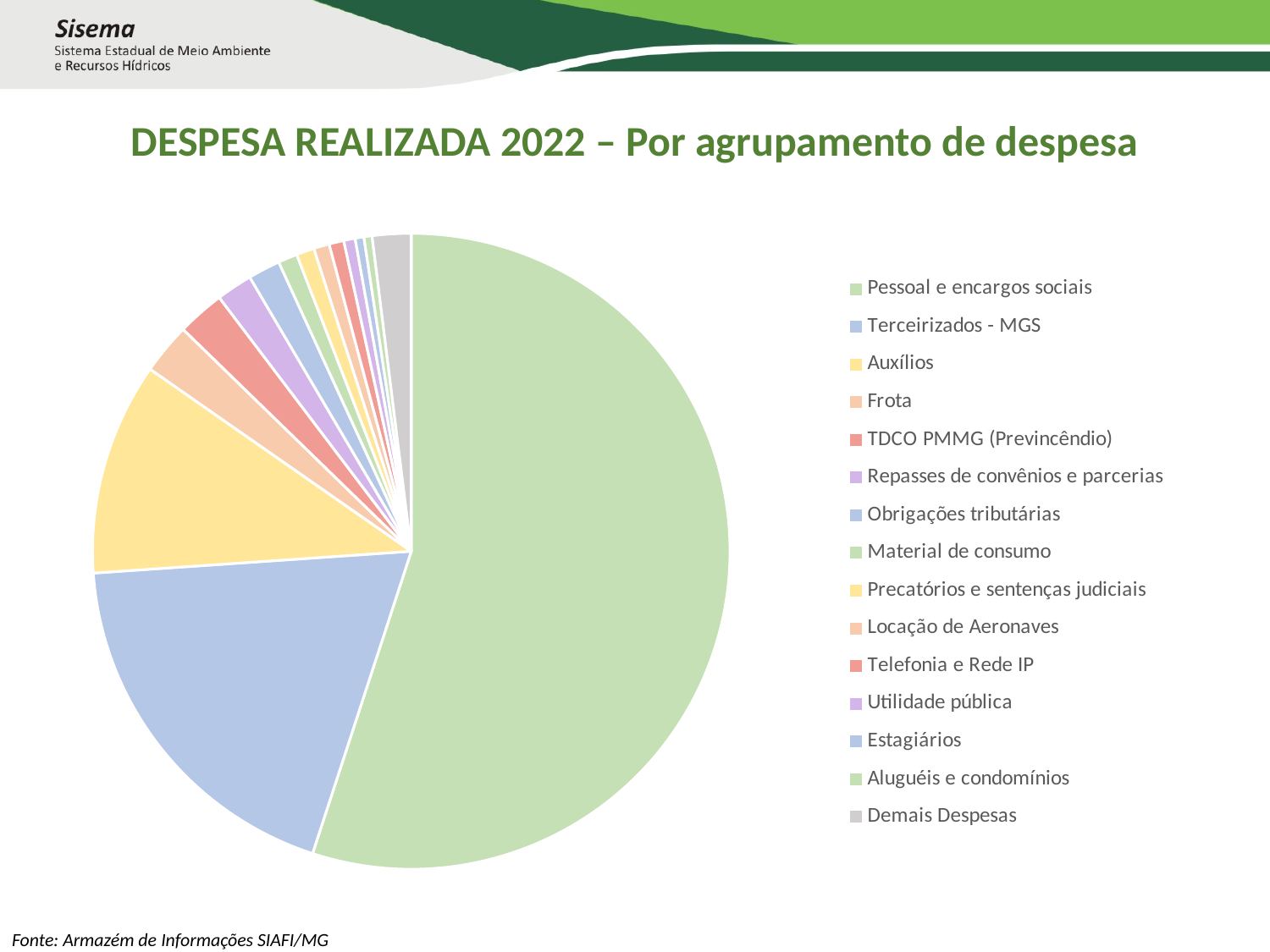
What is the title of the chart on the slide? DESPESA REALIZADA 2022 – Por agrupamento de despesa How many expense categories does the legend of the pie chart list? 15 Which category has the second-largest slice of the pie chart? Terceirizados - MGS Is the slice for Pessoal e encargos sociais larger or smaller than all the other slices combined? Larger What source is cited for the chart data at the bottom of the slide? Armazém de Informações SIAFI/MG Which slice is larger: Auxílios or Frota? Auxílios What kind of chart is shown on the slide? Pie chart Which slice is larger: Pessoal e encargos sociais or Terceirizados - MGS? Pessoal e encargos sociais Which category has the third-largest slice of the pie chart? Auxílios Which category has the largest slice of the pie chart? Pessoal e encargos sociais